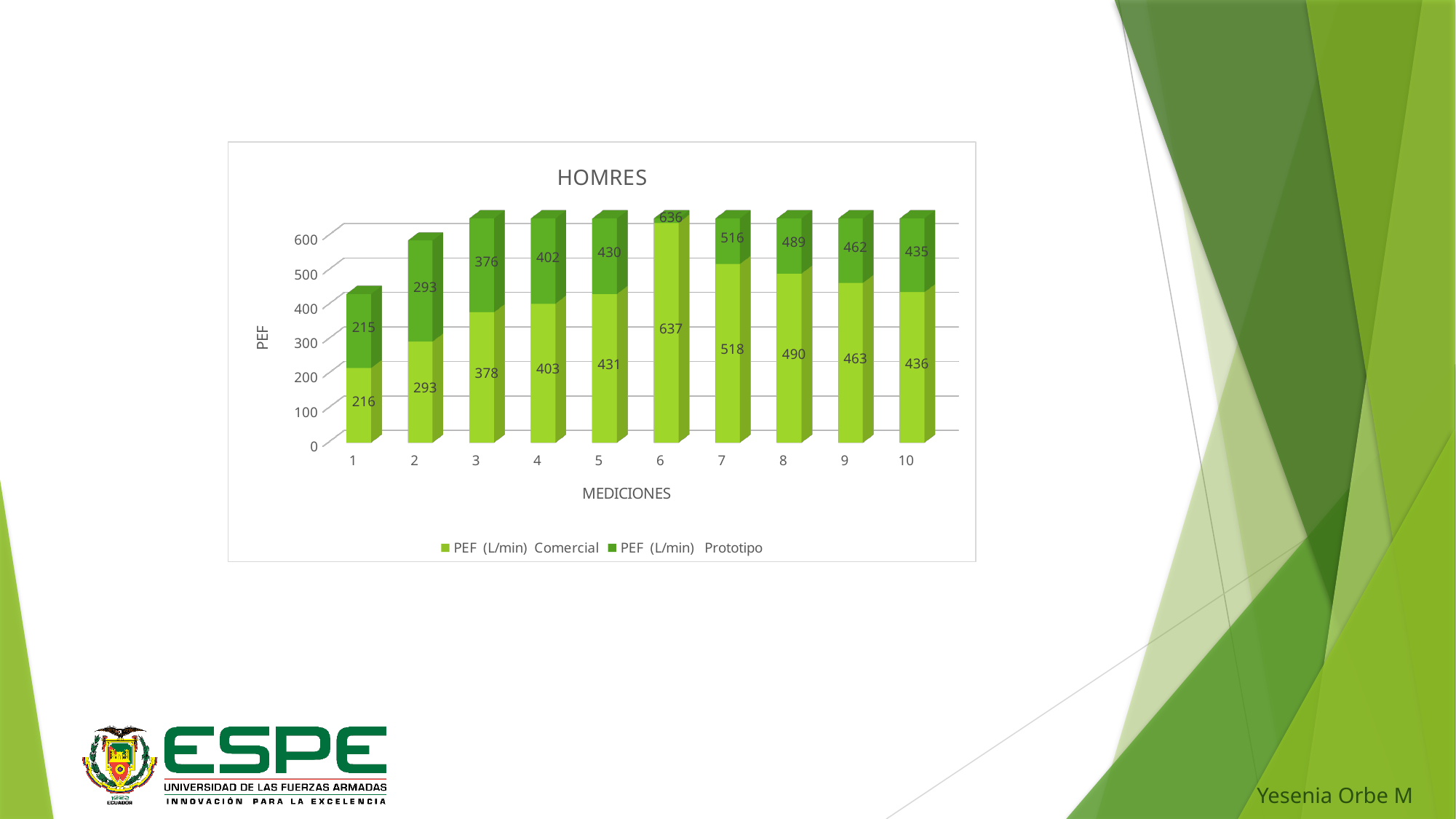
What is the PEF (L/min) Comercial value for measurement 9? 463 What is the total of the stacked bar for measurement 1? 431 Which measurement has the lowest PEF (L/min) Prototipo value? 1 Which measurement has the highest PEF (L/min) Comercial value? 6 How many measurements are shown on the x axis? 10 How many series does the legend list? 2 What kind of chart is shown? Stacked bar chart What is the PEF (L/min) Prototipo value for measurement 3? 376 Which is larger, the PEF (L/min) Comercial value for measurement 7 or for measurement 8? Measurement 7 What is the difference between the PEF (L/min) Comercial values for measurement 6 and measurement 1? 421 From measurement 1 to measurement 6, do the PEF (L/min) Comercial values rise or fall? Rise What is the PEF (L/min) Comercial value for measurement 6? 637